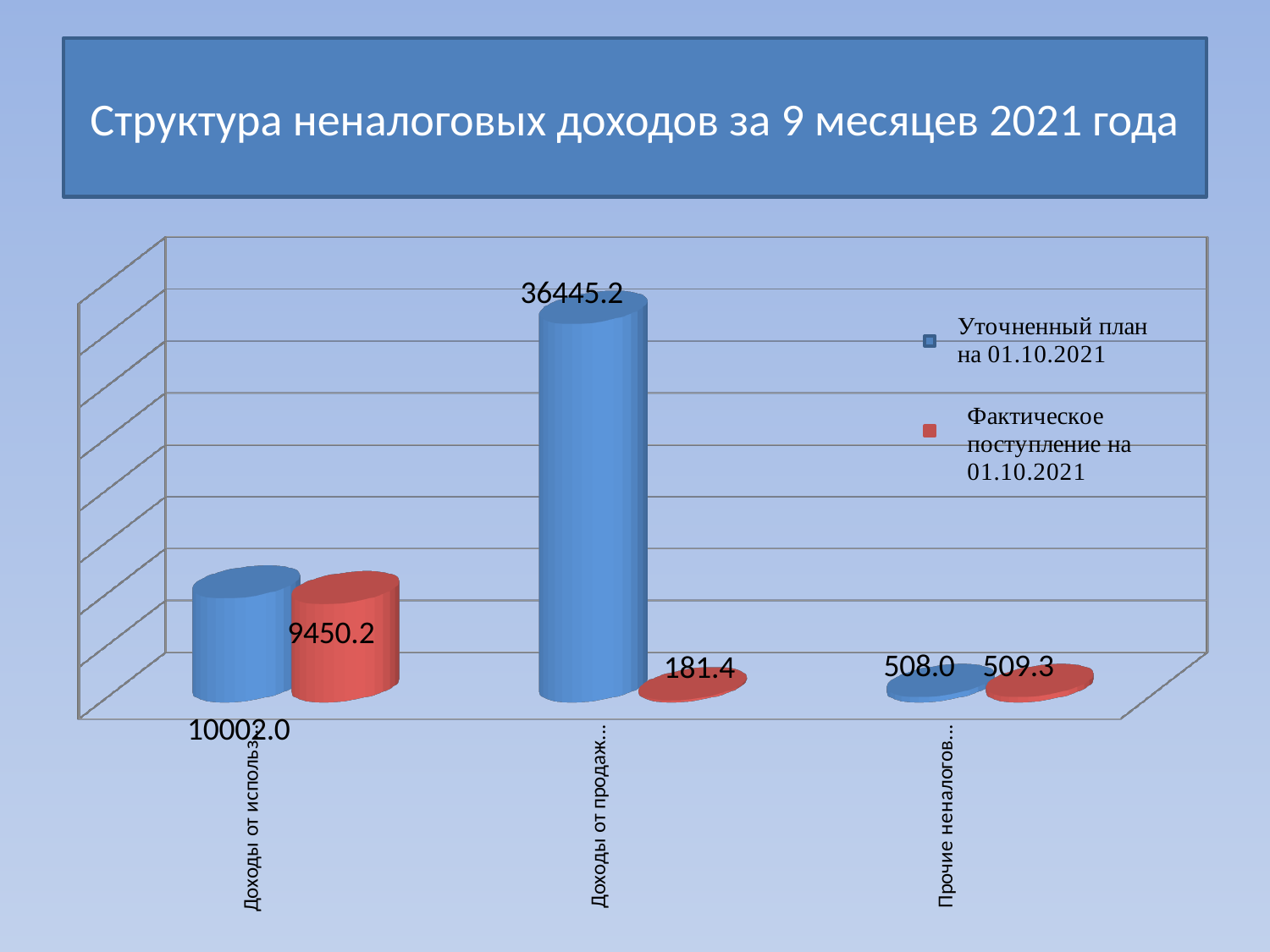
What is the value of the 'Фактическое поступление на 01.10.2021' series for the third category ('Прочие неналогов...')? 509.3 What is the value of the 'Уточненный план на 01.10.2021' series for the second category ('Доходы от продаж...')? 36445.2 What is the difference between the 'Уточненный план' and 'Фактическое поступление' values for the second category ('Доходы от продаж...')? 36263.8 What is the difference between the 'Уточненный план' and 'Фактическое поступление' values for the first category ('Доходы от использ...')? 551.8 For the first category ('Доходы от использ...'), which is larger: the 'Уточненный план' value or the 'Фактическое поступление' value? Уточненный план (10002.0) What is the value of the 'Фактическое поступление на 01.10.2021' series for the first category ('Доходы от использ...')? 9450.2 Which category has the highest value in the 'Уточненный план на 01.10.2021' series? Доходы от продаж... (the second category) Which category has the lowest value in the 'Фактическое поступление на 01.10.2021' series? Доходы от продаж... (the second category) What type of chart is shown on the slide? Bar chart How many categories are shown on the x axis of the chart? 3 How many series does the chart legend list? 2 What is the value of the 'Уточненный план на 01.10.2021' series for the first category ('Доходы от использ...')? 10002.0